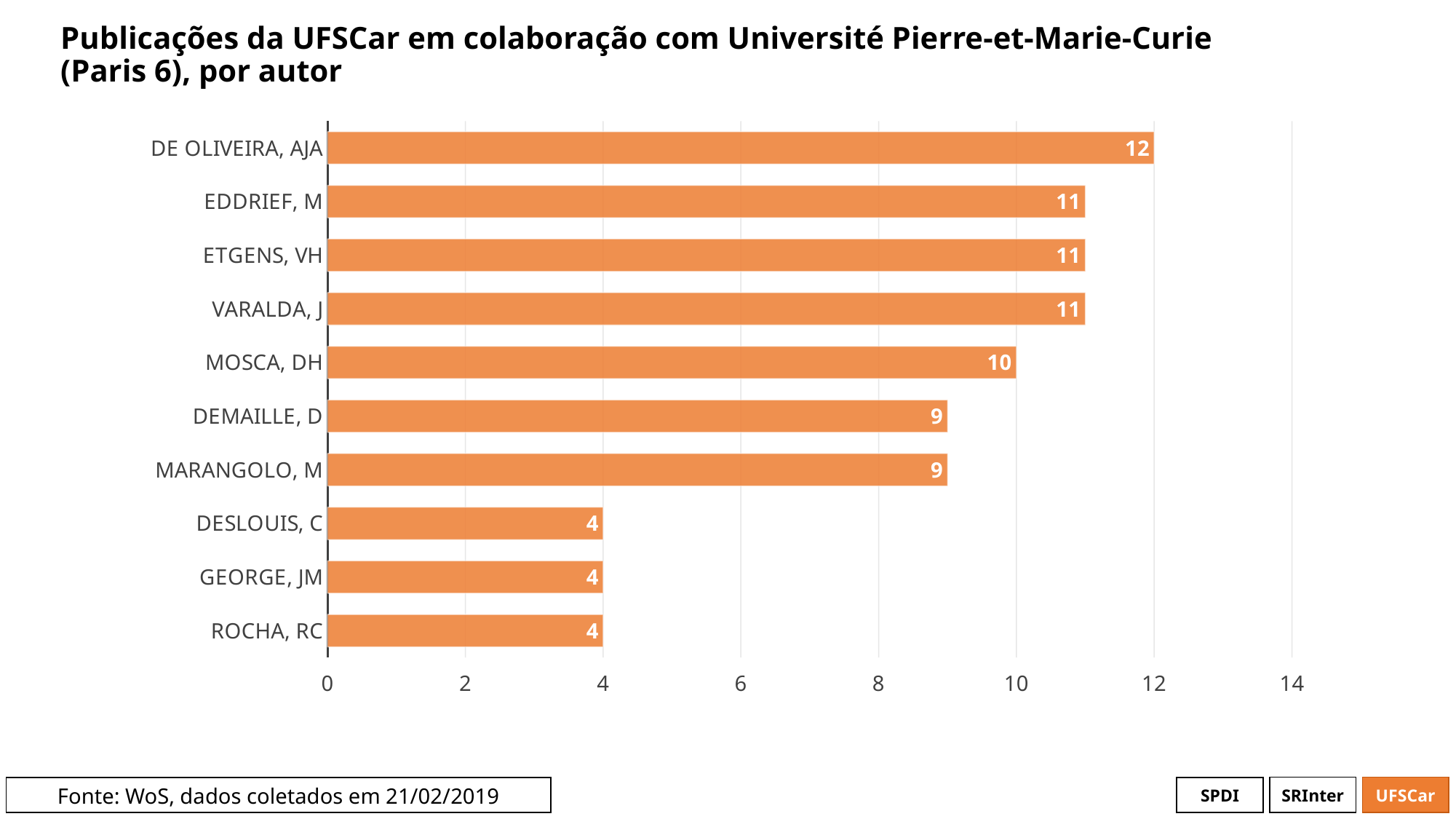
How many authors have a value of 11? 3 What is the value for DEMAILLE, D? 9 Is the value for VARALDA, J greater or less than 10? greater Which author has the highest number of publications? DE OLIVEIRA, AJA How many authors are shown in the chart? 10 What is the difference between the values for EDDRIEF, M and MOSCA, DH? 1 How many publications does DE OLIVEIRA, AJA have? 12 What is the value for MOSCA, DH? 10 What is the difference between the values for DE OLIVEIRA, AJA and ROCHA, RC? 8 What is the data source stated on the slide? WoS, dados coletados em 21/02/2019 Which is larger, the value for MARANGOLO, M or the value for GEORGE, JM? MARANGOLO, M What kind of chart is shown on the slide? Bar chart